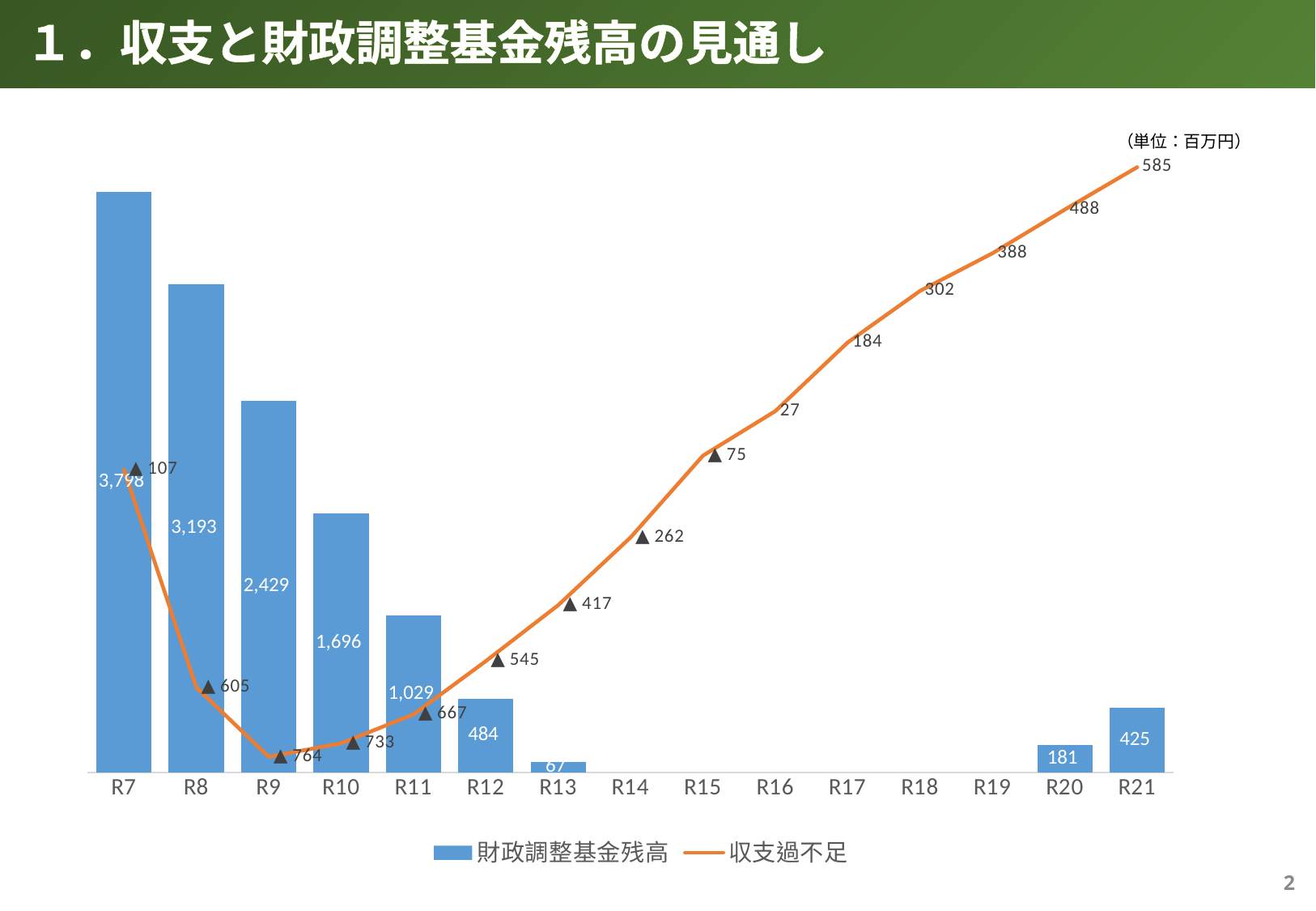
Which year has the highest 財政調整基金残高? R7 How many years are shown on the x axis? 15 What kind of chart is this? Combined bar and line chart What is the difference between the 財政調整基金残高 for R7 and R8? 605 What is the value of 財政調整基金残高 for R7? 3,798 Which is larger, the 財政調整基金残高 for R12 or for R21? R12 Does the 収支過不足 line rise or fall from R9 to R21? Rise What is the value of 収支過不足 for R21? 585 Which year has the highest 収支過不足 value on the line? R21 What is the value of 財政調整基金残高 for R20? 181 How many series does the legend list? 2 What is the value of 収支過不足 for R9? ▲ 764